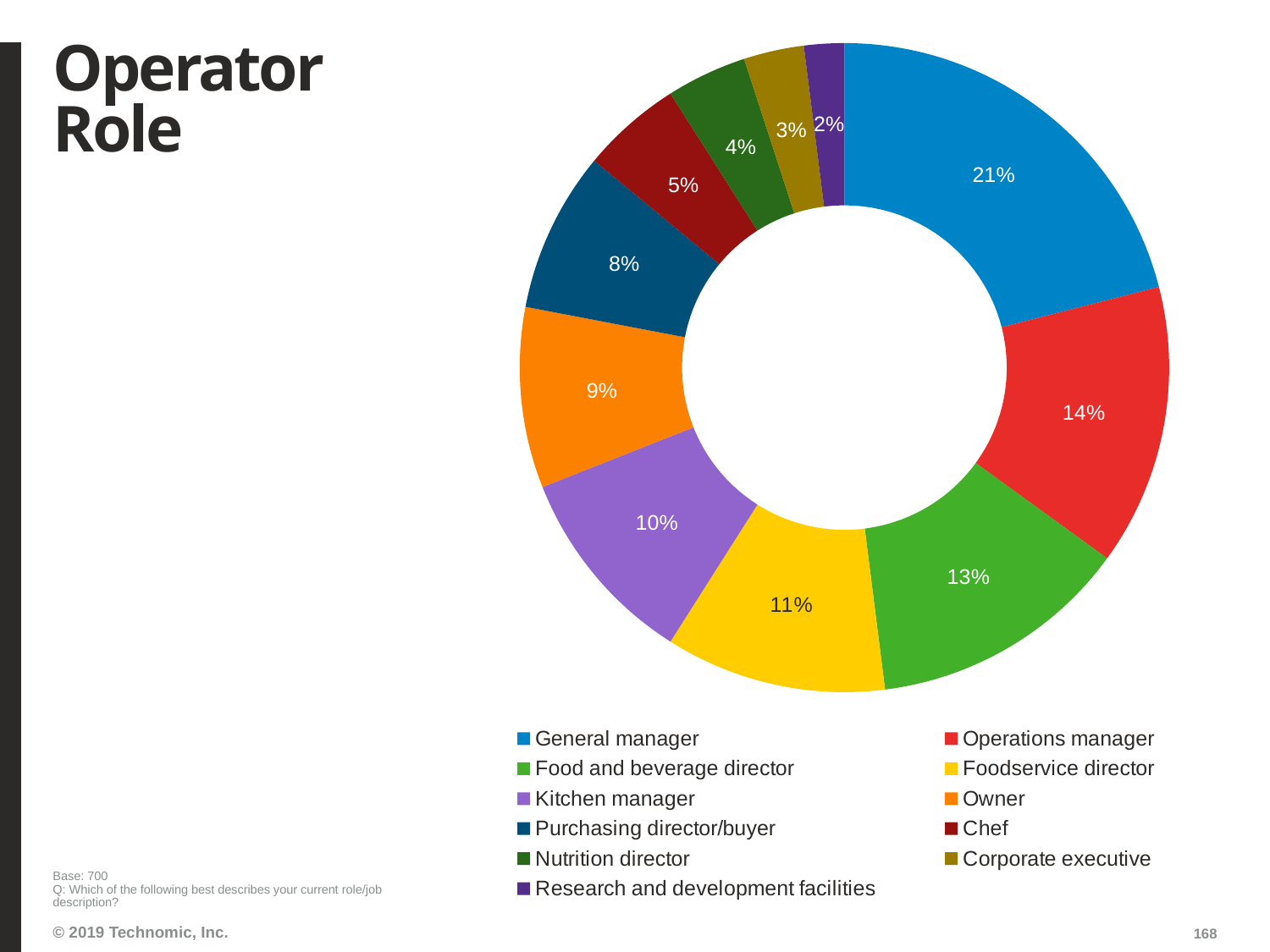
What is the value for Chef? 5% What is the combined share of Nutrition director and Corporate executive? 7% What percentage of respondents are Owners? 9% What kind of chart is shown on the slide? Pie chart (donut) What is the title of the slide? Operator Role Which operator role has the smallest share? Research and development facilities Which is larger, the share for Kitchen manager or the share for Purchasing director/buyer? Kitchen manager What is the difference between the shares for General manager and Operations manager? 7% What share of operators are General managers? 21% Which operator role has the largest share? General manager How many operator roles are shown in the chart? 11 What is the value for Foodservice director? 11%